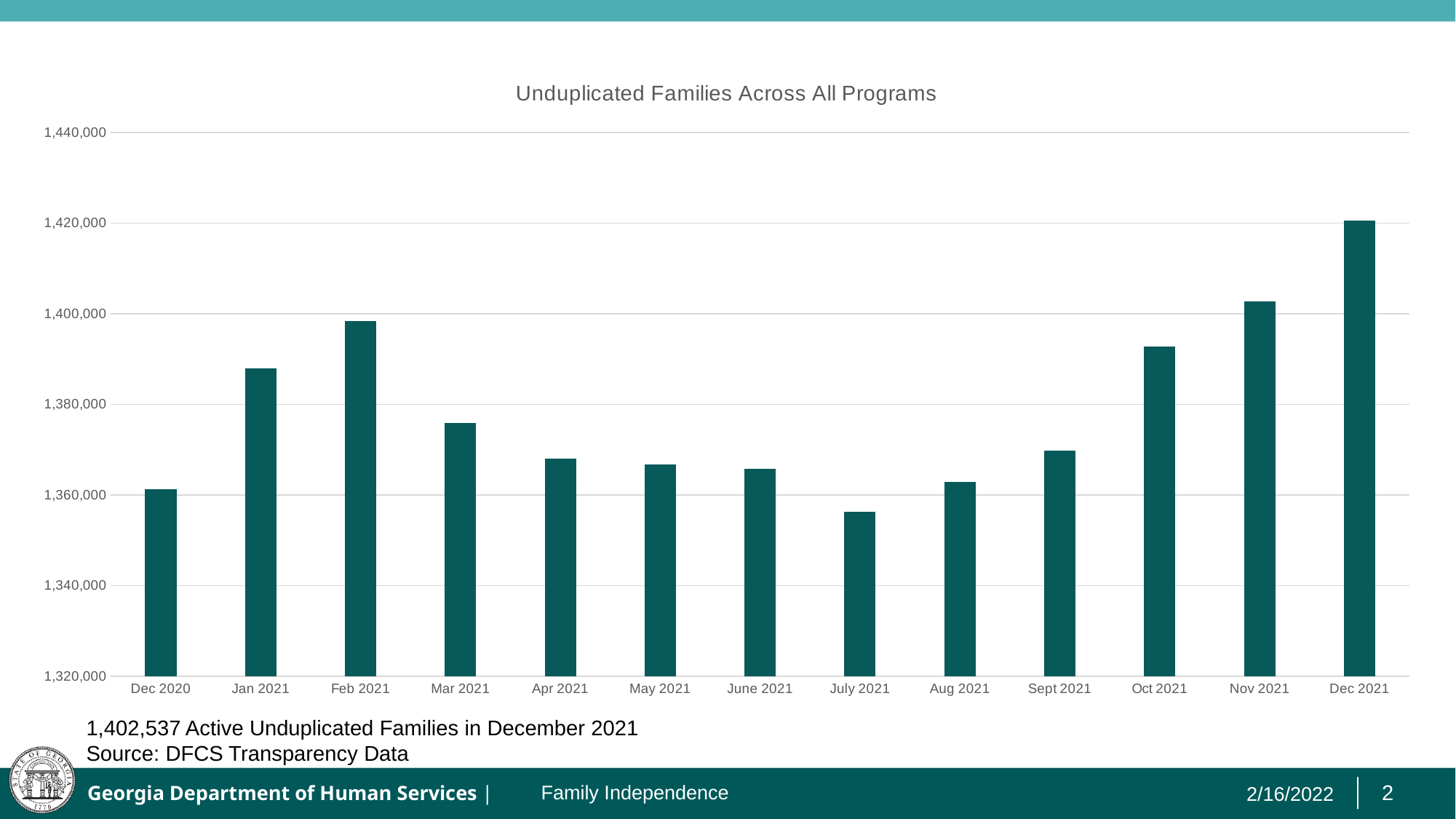
According to the text below the chart, what is the source of the data? DFCS Transparency Data Do the values rise or fall from July 2021 to Dec 2021? rise Is the value for Jan 2021 greater or less than 1,380,000? greater What is the title of the chart? Unduplicated Families Across All Programs Which is larger, the value for Feb 2021 or the value for Mar 2021? Feb 2021 How many months are plotted on the x axis of the chart? 13 Is the value for July 2021 greater or less than 1,360,000? less Is the value for Dec 2021 greater or less than 1,400,000? greater What type of chart is shown on the slide? Bar chart Which month has the highest number of unduplicated families? Dec 2021 Which month has the lowest number of unduplicated families? July 2021